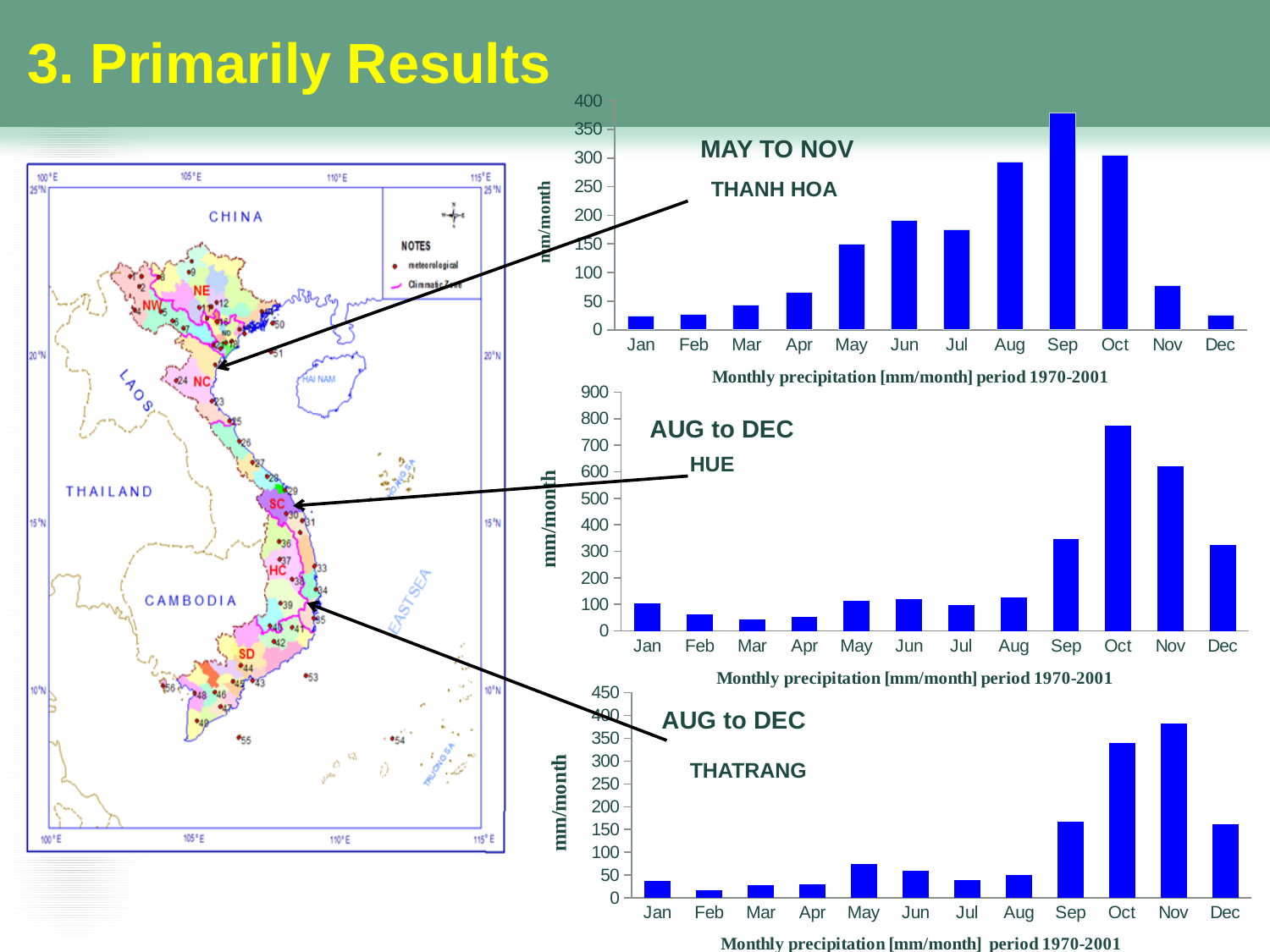
In the Thatrang chart (bottom), which month has the lowest precipitation? Feb How many months are plotted in the Hue chart (middle)? 12 In the Thatrang chart (bottom), which month has the highest precipitation? Nov In the Hue chart (middle), which month has the larger value, Oct or Nov? Oct In the Thanh Hoa chart (top), which month has the larger value, Sep or Oct? Sep In the Hue chart (middle), is the value for Sep greater or less than 300? greater In the Thanh Hoa chart (top), is the value for Sep greater or less than 350? greater What kind of chart is the Thatrang chart (bottom)? bar chart In the Thatrang chart (bottom), is the value for Feb greater or less than 50? less In the Thanh Hoa chart (top), which month has the highest precipitation? Sep In the Hue chart (middle), which month has the highest precipitation? Oct